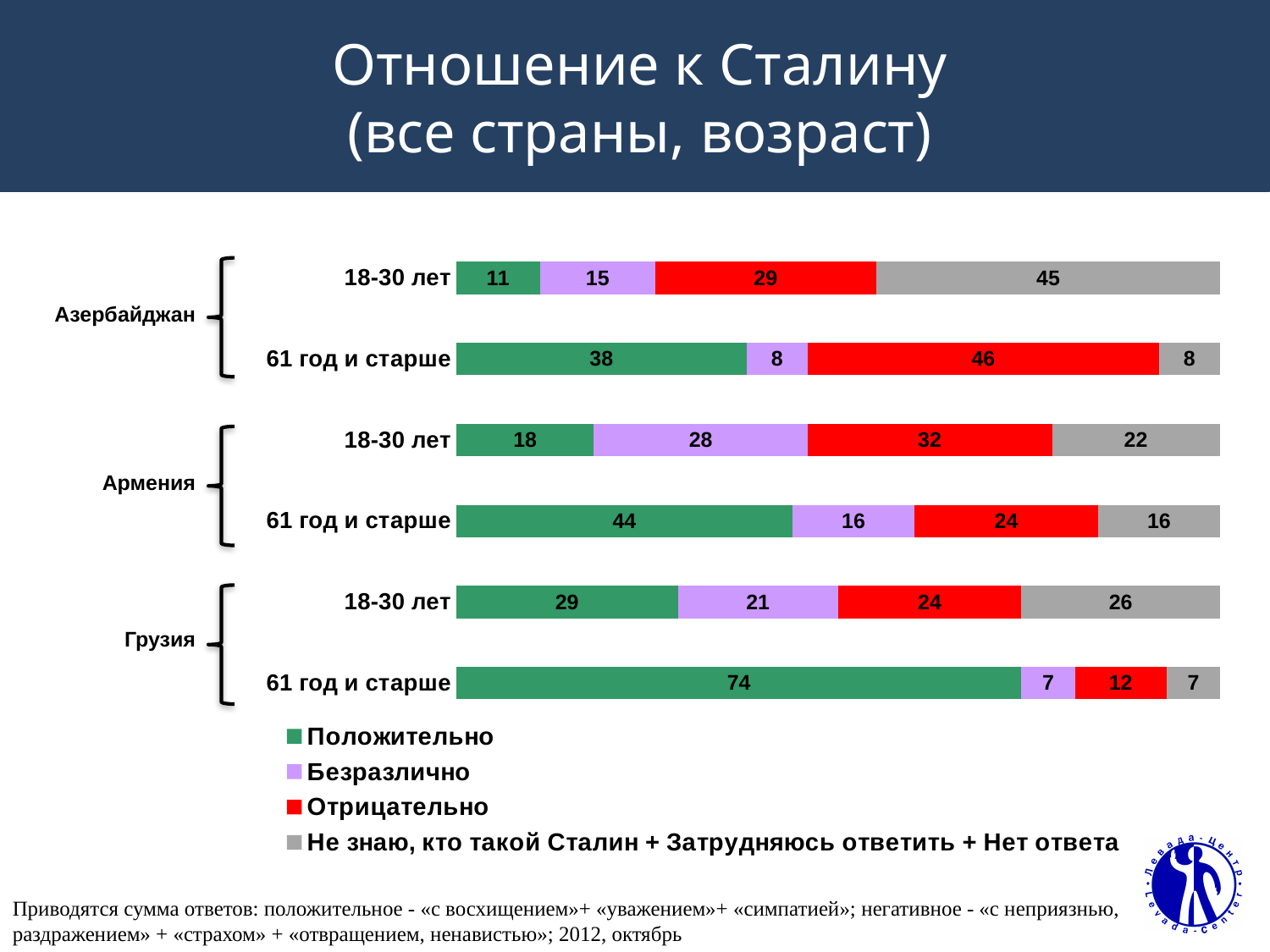
What is the value of «Отрицательно» for Азербайджан, 61 год и старше? 46 How many bars are shown in the chart? 6 What kind of chart is shown on the slide? Stacked bar chart What is the value of «Положительно» for Грузия, 61 год и старше? 74 Which bar has the highest value for «Положительно»? Грузия, 61 год и старше What is the value of «Безразлично» for Армения, 18-30 лет? 28 What is the difference between the «Положительно» values for Армения 61 год и старше and Армения 18-30 лет? 26 Which colour represents «Отрицательно» in the legend? Red What is the total of the stacked bar for Грузия, 18-30 лет? 100 Which is larger: the «Отрицательно» value for Азербайджан 18-30 лет or for Грузия 18-30 лет? Азербайджан 18-30 лет How many series does the legend list? 4 Which bar has the lowest value for «Положительно»? Азербайджан, 18-30 лет